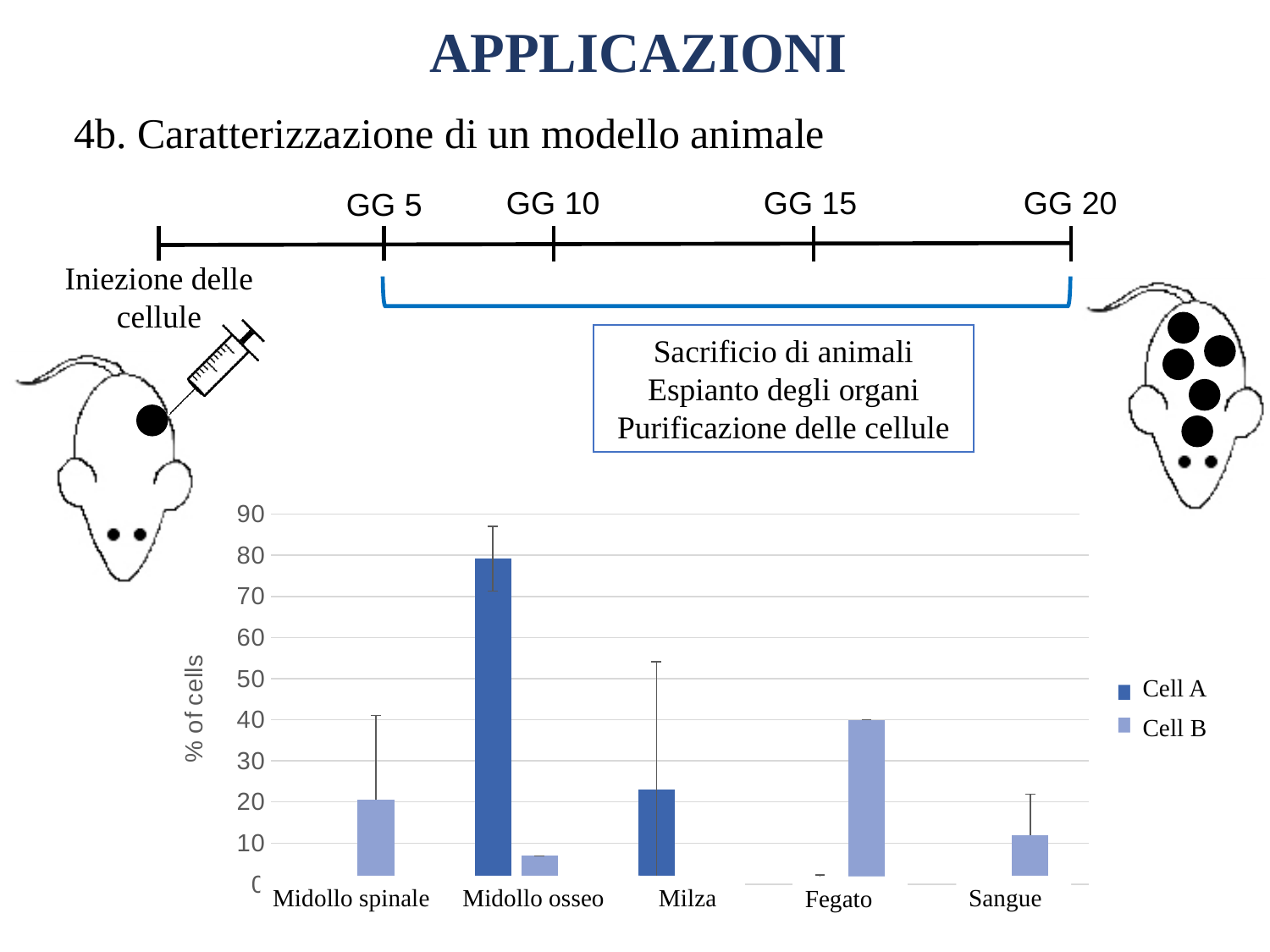
Is the Cell B value for Sangue greater or less than 20? less How many categories are shown on the x axis of the chart? 5 Is the Cell A value for Milza greater or less than 30? less How many series does the chart legend list? 2 Which is larger: the Cell B value for Fegato or the Cell B value for Midollo spinale? Fegato Is the Cell A value for Midollo osseo greater or less than 70? greater Which category has the highest Cell B value? Fegato Which is larger for Midollo osseo: the Cell A value or the Cell B value? Cell A What is the label of the y axis of the chart? % of cells Which category has the highest Cell A value? Midollo osseo What kind of chart is shown on the slide? bar chart